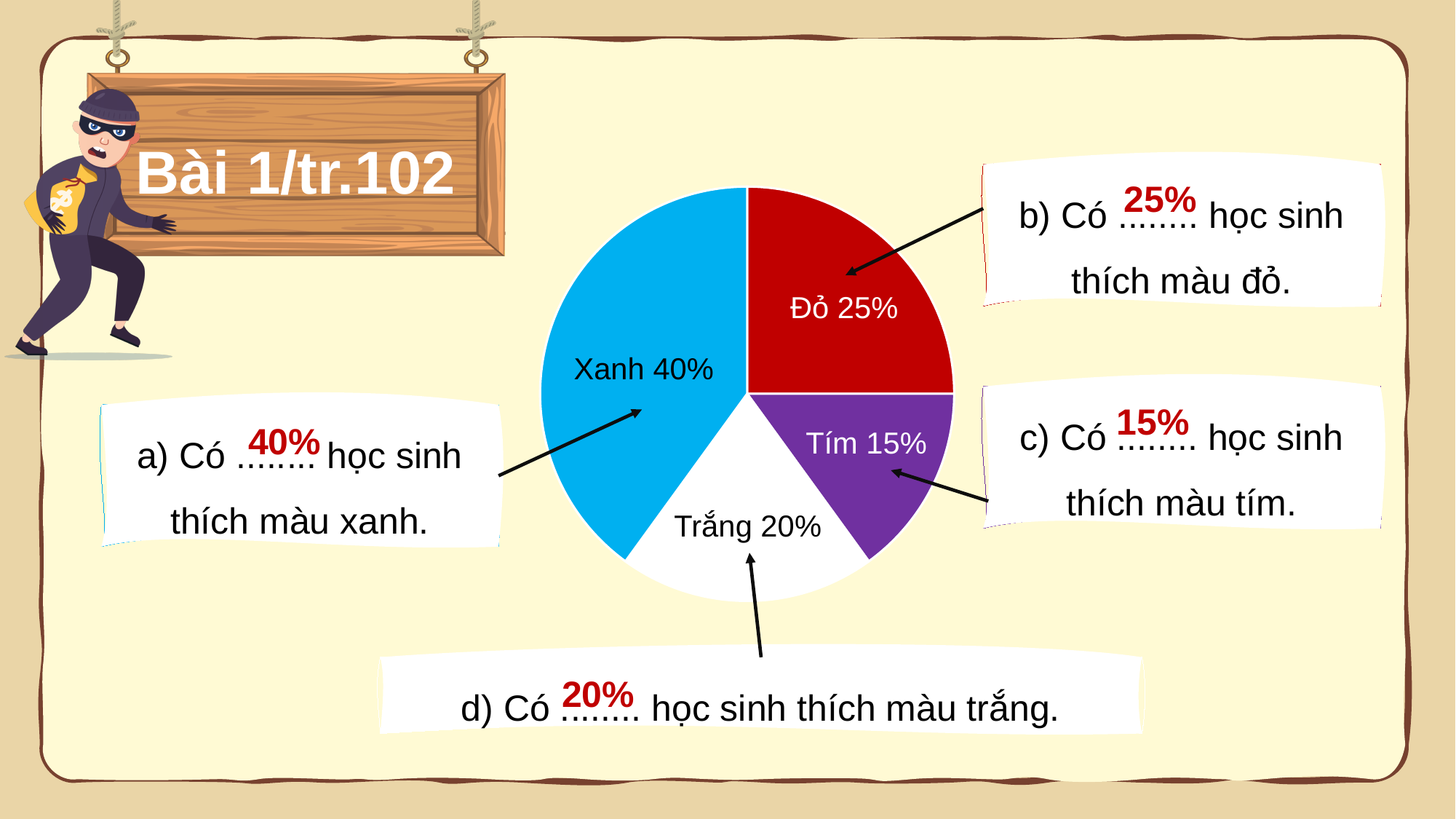
What kind of chart is shown on the slide? pie chart How many slices does the pie chart have? 4 What percentage of students like the colour Đỏ (red)? 25% What percentage of students like the colour Tím (purple)? 15% What is the combined share of Đỏ and Tím? 40% What is the difference between the share for Xanh and the share for Tím? 25% Which is larger, the share for Đỏ or the share for Trắng? Đỏ Which colour has the largest share of the pie? Xanh What colour is the slice labelled Tím 15% drawn in? purple What percentage of students like the colour Trắng (white)? 20% What percentage of students like the colour Xanh (blue)? 40% Which colour has the smallest share of the pie? Tím